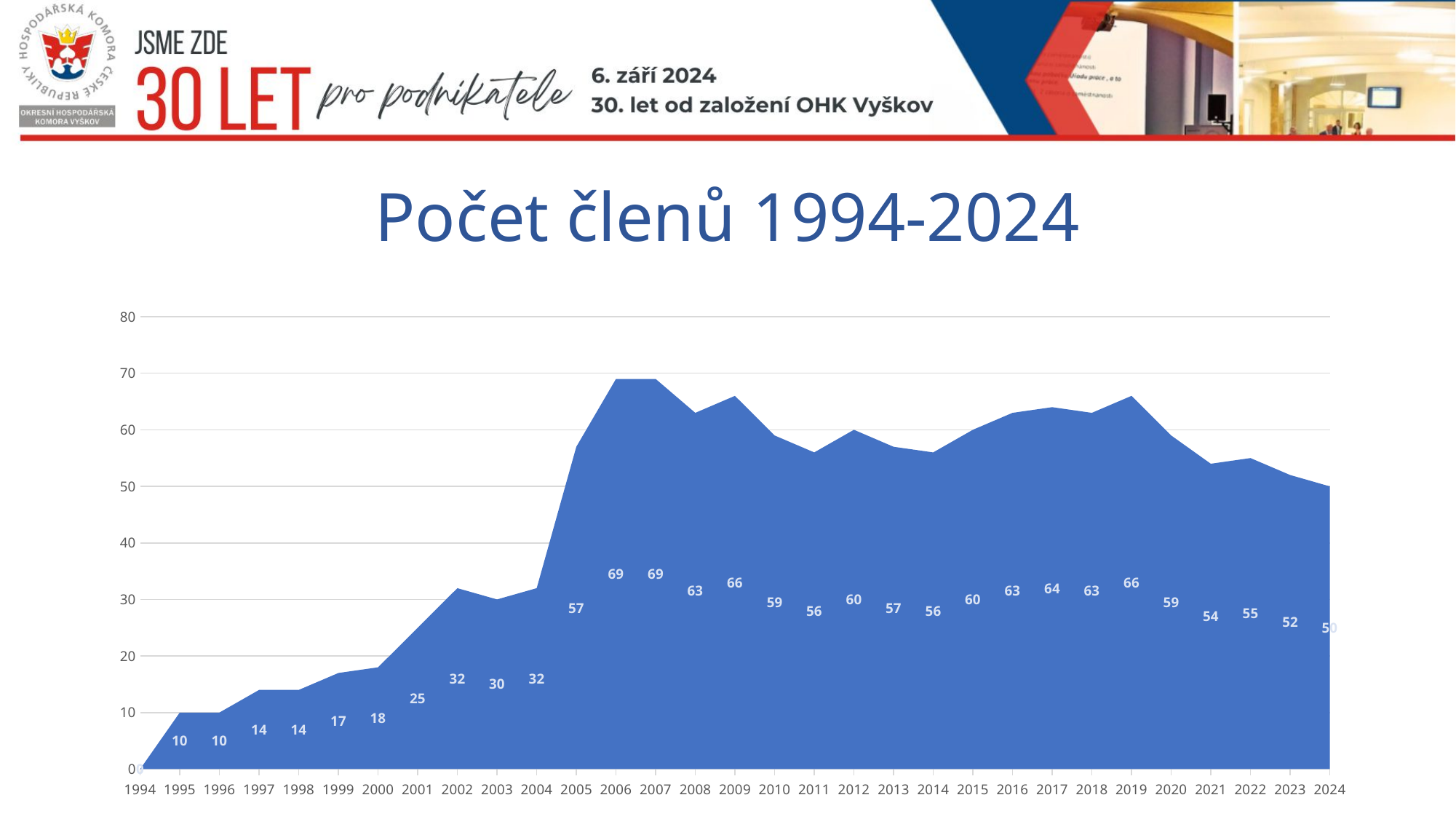
What is the value for 2005? 57 Which is larger, the value for 2012 or the value for 2014? 2012 Which year has the lowest value? 1994 How many years are plotted on the x axis? 31 What is the value for 2019? 66 What is the value for 2024? 50 What is the difference between the values for 2007 and 2024? 19 What is the highest value shown in the chart? 69 What is the value for 2001? 25 What kind of chart is shown on the slide? area chart Is the value for 2009 greater or less than 60? greater What is the title of the chart? Počet členů 1994-2024